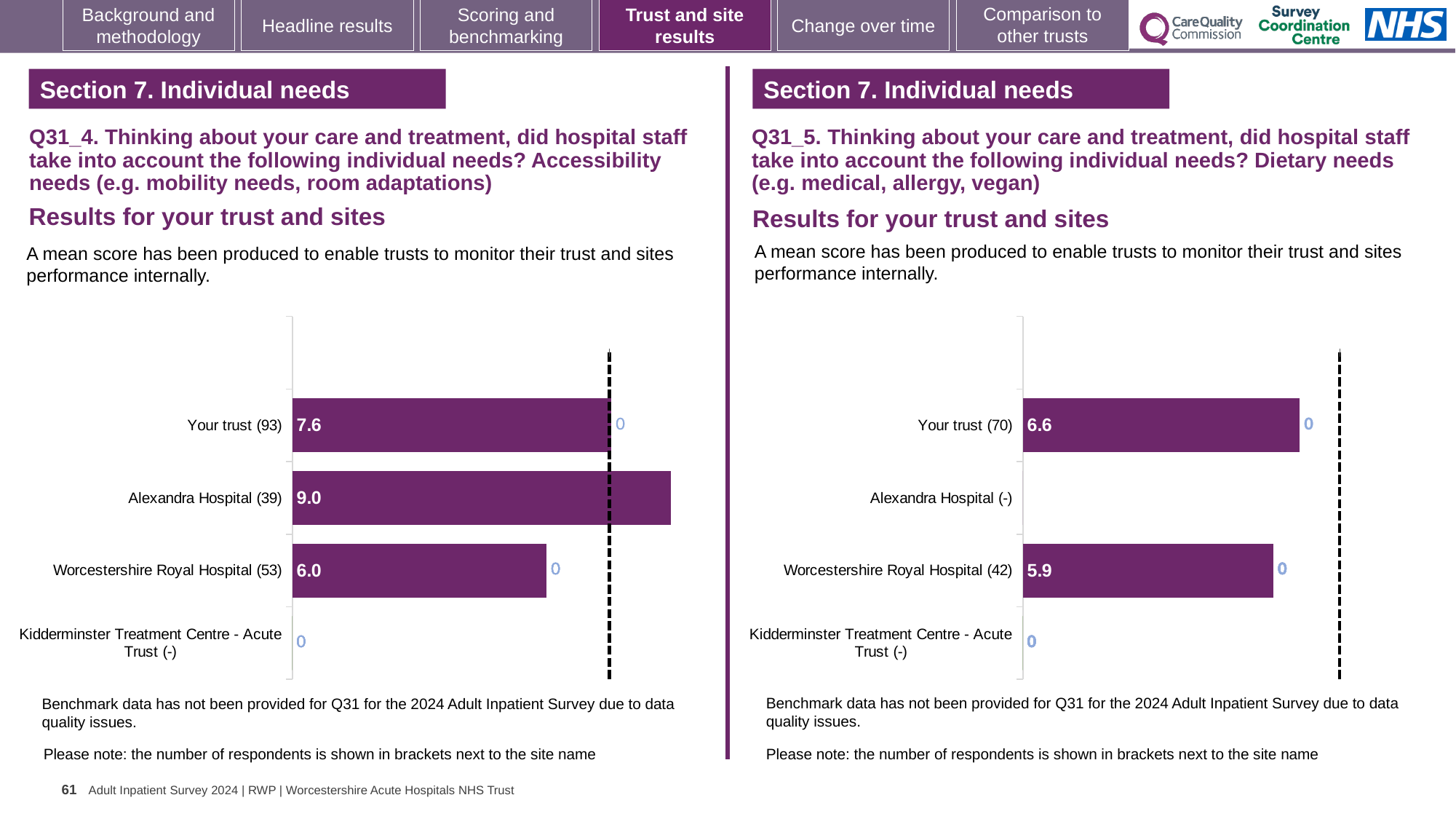
In the Q31_4 Accessibility needs chart on the left, what is the mean score for Your trust? 7.6 In the Q31_5 Dietary needs chart on the right, what is the difference between the mean scores for Your trust and Worcestershire Royal Hospital? 0.7 In the Q31_5 Dietary needs chart on the right, what is the mean score for Your trust? 6.6 In the Q31_5 Dietary needs chart on the right, what is the mean score for Worcestershire Royal Hospital? 5.9 In the Q31_5 Dietary needs chart on the right, which has the larger mean score, Your trust or Worcestershire Royal Hospital? Your trust In the Q31_4 Accessibility needs chart on the left, what is the mean score for Worcestershire Royal Hospital? 6.0 What kind of chart is used for the Q31_5 Dietary needs results on the right? Bar chart In the Q31_4 Accessibility needs chart on the left, what is the mean score for Alexandra Hospital? 9.0 How many categories are listed on the vertical axis of the Q31_4 Accessibility needs chart on the left? 4 In the Q31_4 Accessibility needs chart on the left, what is the difference between the mean scores for Alexandra Hospital and Worcestershire Royal Hospital? 3.0 In the Q31_4 Accessibility needs chart on the left, which site has the highest mean score? Alexandra Hospital In the Q31_5 Dietary needs chart on the right, how many respondents are shown in brackets for Your trust? 70